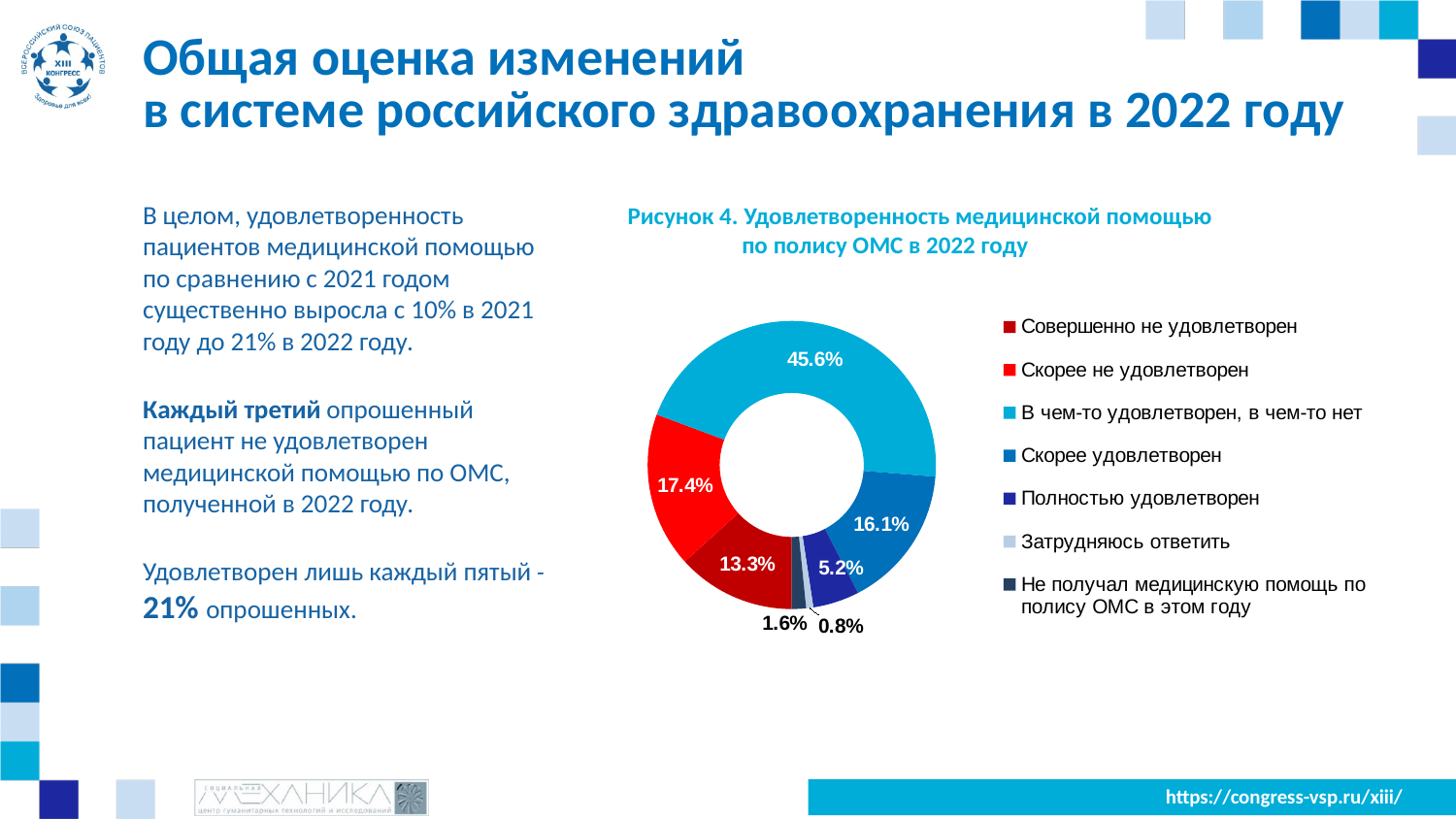
What share of respondents answered "В чем-то удовлетворен, в чем-то нет"? 45.6% What share of respondents answered "Скорее удовлетворен"? 16.1% What kind of chart is shown on the slide? Doughnut (pie) chart How many categories does the chart legend list? 7 What is the smallest percentage shown on the chart? 0.8% What is the title of the chart? Рисунок 4. Удовлетворенность медицинской помощью по полису ОМС в 2022 году What share of respondents answered "Полностью удовлетворен"? 5.2% What is the difference between the shares for "Скорее не удовлетворен" and "Совершенно не удовлетворен"? 4.1% Which category has the largest share in the chart? В чем-то удовлетворен, в чем-то нет What share of respondents answered "Скорее не удовлетворен"? 17.4% Which is larger: the share for "Скорее удовлетворен" or for "Скорее не удовлетворен"? Скорее не удовлетворен What share of respondents answered "Совершенно не удовлетворен"? 13.3%